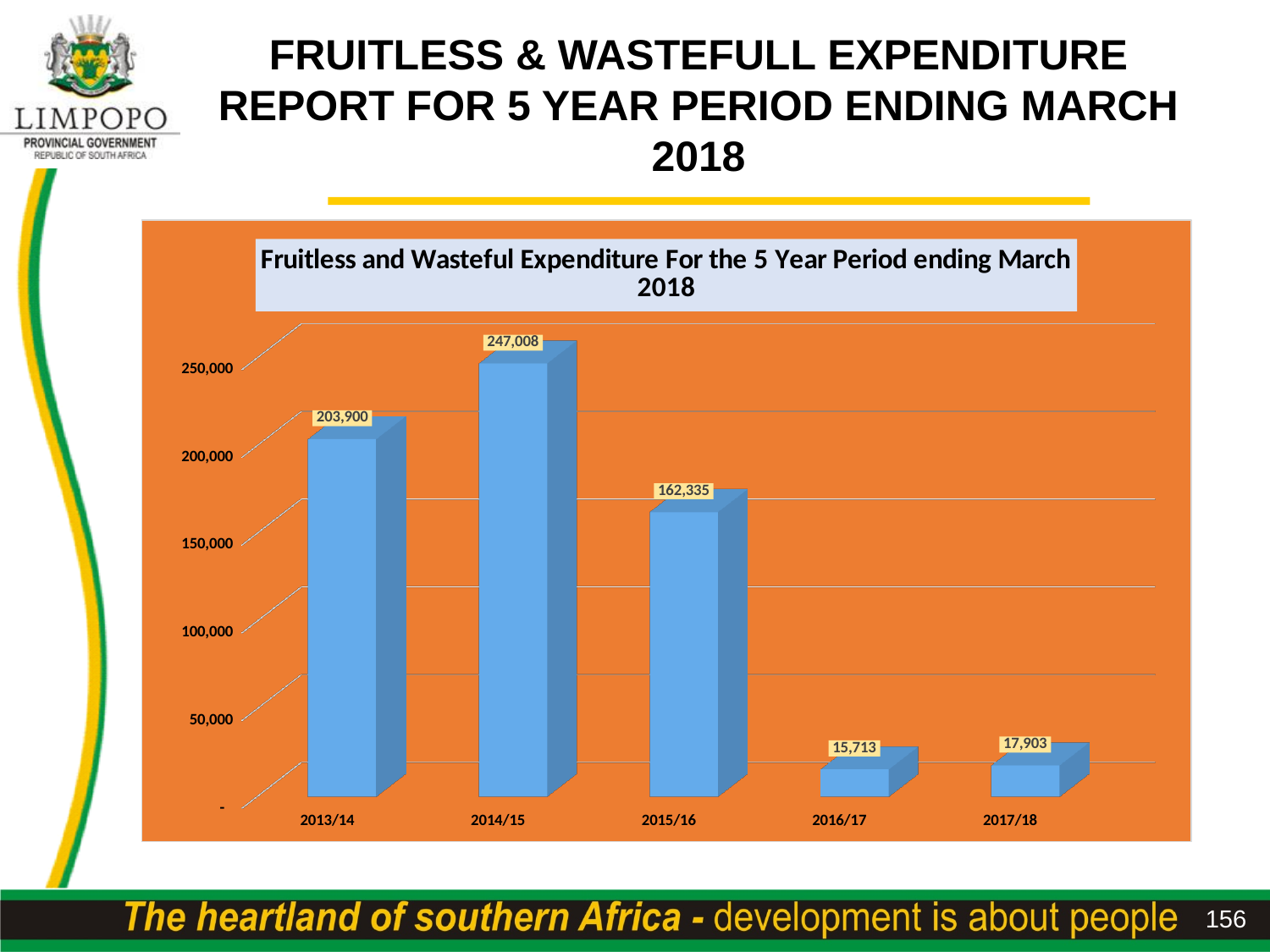
What is the value for 2015/16? 162,335 What is the difference between the values for 2014/15 and 2013/14? 43,108 Which year has the lowest fruitless and wasteful expenditure? 2016/17 What is the title of the chart? Fruitless and Wasteful Expenditure For the 5 Year Period ending March 2018 How many years are shown on the x axis? 5 Which year has the highest fruitless and wasteful expenditure? 2014/15 What is the value for 2017/18? 17,903 What is the value for 2013/14? 203,900 What is the value for 2016/17? 15,713 What kind of chart is shown on the slide? Bar chart What is the value for 2014/15? 247,008 Which is larger, the value for 2013/14 or the value for 2015/16? 2013/14